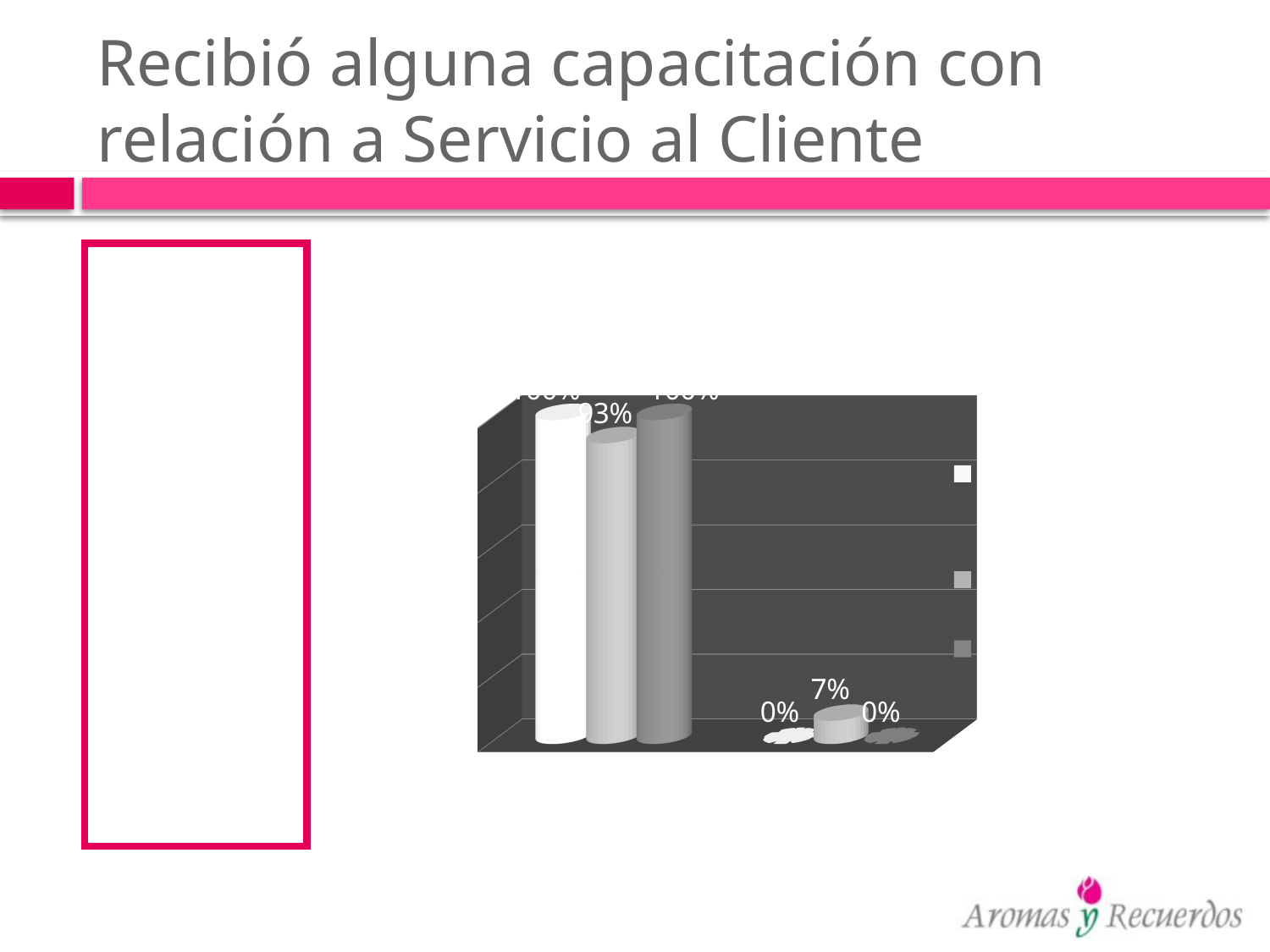
How many series does the legend list? 3 What is the value labelled on the first (white) bar of the right group? 0% How many bars are plotted in total in the chart? 6 What kind of chart is shown on the slide? Bar chart Which bar in the left group is the lowest? The middle (light grey) bar What is the value labelled on the third (dark grey) bar of the right group? 0% What is the difference between the middle bar of the left group (93%) and the middle bar of the right group (7%)? 86% What is the value labelled on the middle (light grey) bar of the right group? 7% Which bar in the right group is the highest? The middle (light grey) bar Which is larger: the middle bar of the left group or the middle bar of the right group? The middle bar of the left group How many groups of bars are plotted in the chart? 2 What is the value labelled on the middle (light grey) bar of the left group? 93%